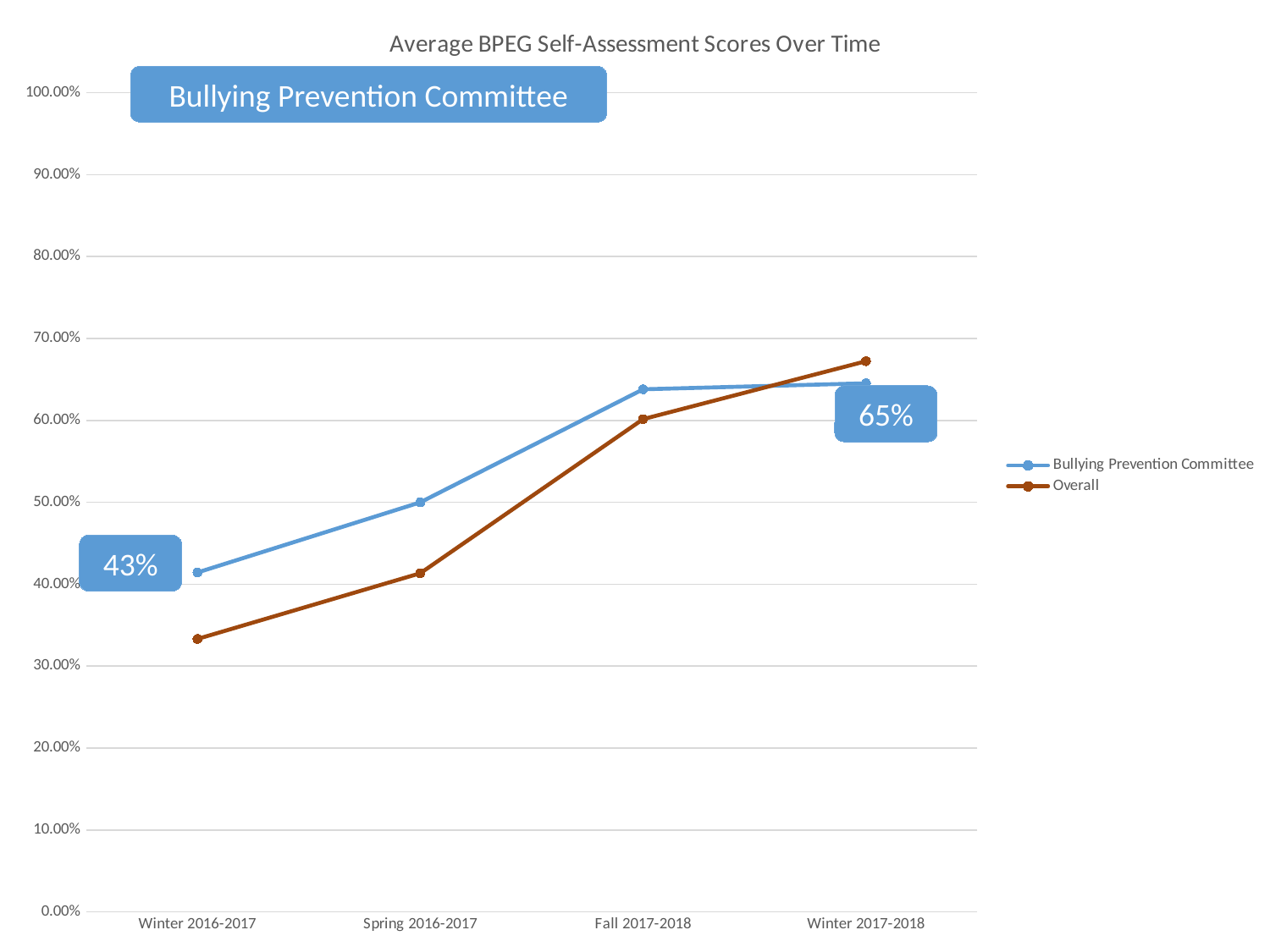
Is the Bullying Prevention Committee value for Fall 2017-2018 greater or less than 60%? greater How many series does the legend list? 2 In which period is the Bullying Prevention Committee score lowest? Winter 2016-2017 What kind of chart is shown on the slide? line chart In Winter 2016-2017, which series has the higher score, Bullying Prevention Committee or Overall? Bullying Prevention Committee In Winter 2017-2018, which series has the higher score, Bullying Prevention Committee or Overall? Overall Is the Overall value for Winter 2016-2017 greater or less than 40%? less How many time periods are shown on the x axis? 4 Which series is plotted in blue? Bullying Prevention Committee Do the Overall scores rise or fall from Winter 2016-2017 to Winter 2017-2018? rise What is the title of the chart? Average BPEG Self-Assessment Scores Over Time In which period is the Overall score highest? Winter 2017-2018